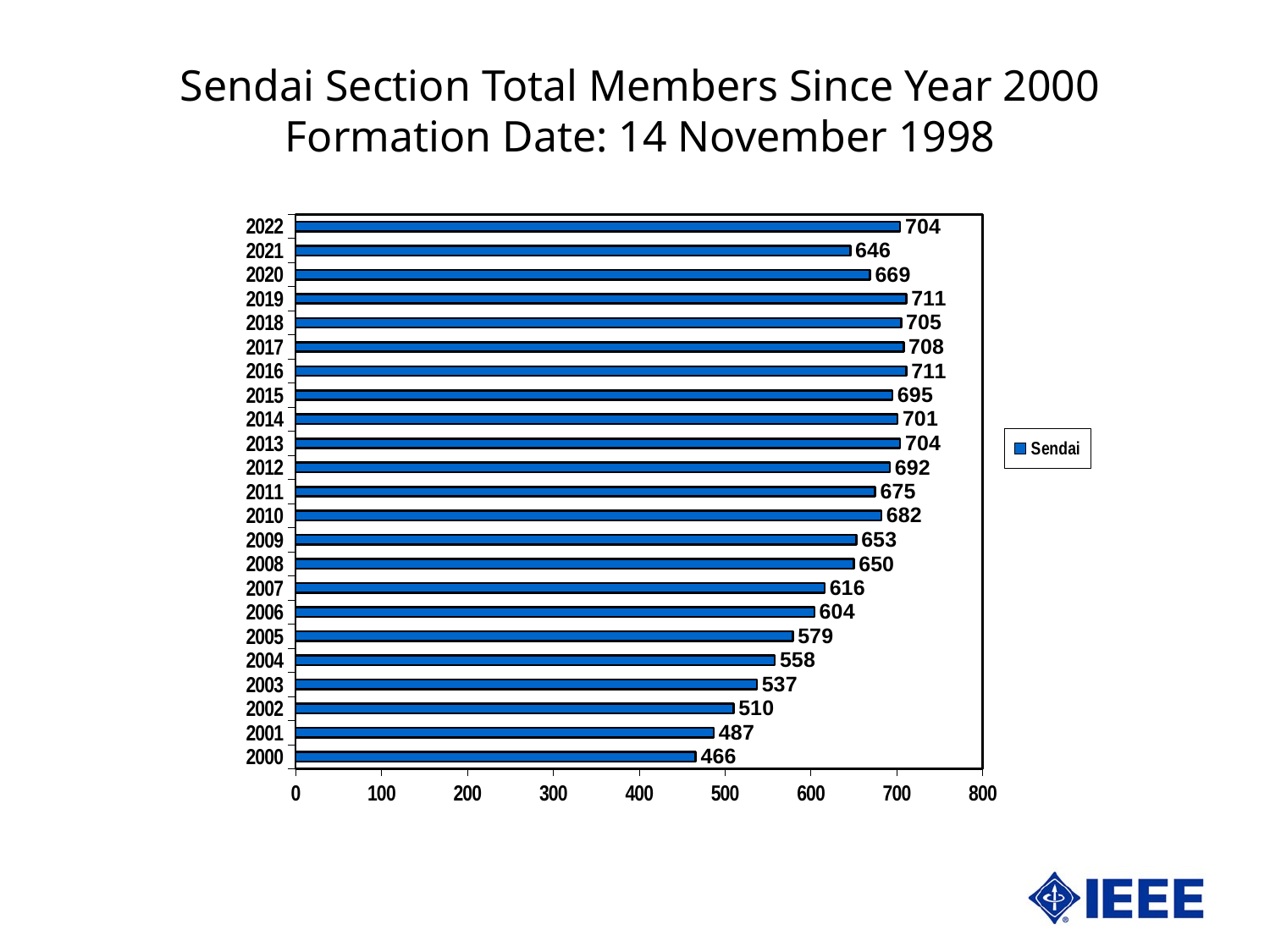
How many years are shown on the chart? 23 Which year has the lowest value? 2000 What is the value for 2022? 704 What kind of chart is shown? bar chart What is the difference between the values for 2022 and 2000? 238 Which is larger, the value for 2011 or the value for 2012? 2012 Is the value for 2001 greater or less than 500? less What is the difference between the values for 2020 and 2021? 23 How many series does the legend list? 1 What is the value for 2013? 704 What is the value for 2000? 466 What is the name of the series in the legend? Sendai